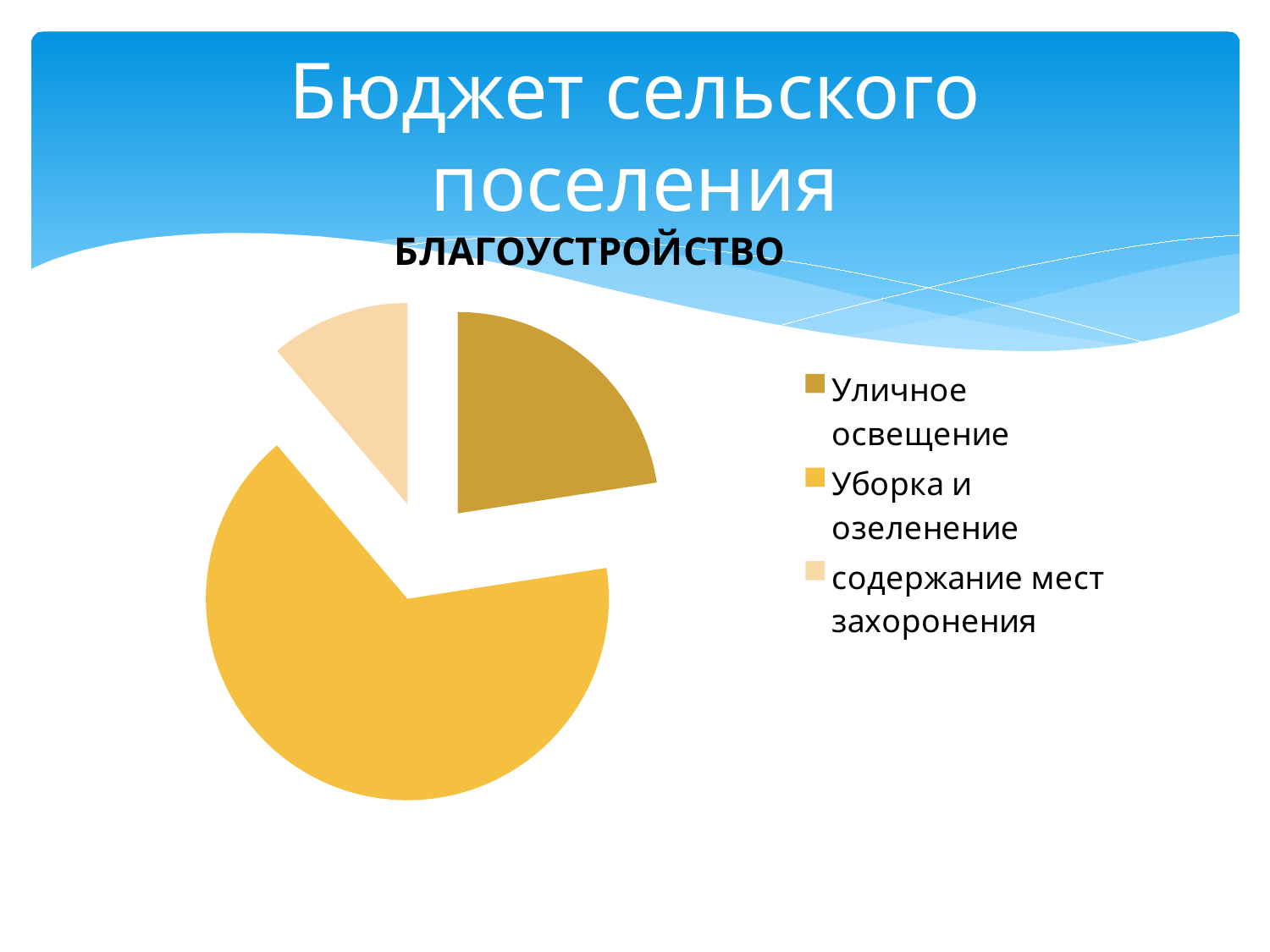
Which slice is larger: Уличное освещение or содержание мест захоронения? Уличное освещение Which slice is larger: Уборка и озеленение or Уличное освещение? Уборка и озеленение How many entries does the legend of the pie chart list? 3 Which legend entry is shown in the lightest colour? содержание мест захоронения How many slices does the pie chart have? 3 Which category has the smallest slice of the pie chart? содержание мест захоронения What kind of chart is shown on the slide? pie chart Which category has the largest slice of the pie chart? Уборка и озеленение What is the title of the pie chart? БЛАГОУСТРОЙСТВО